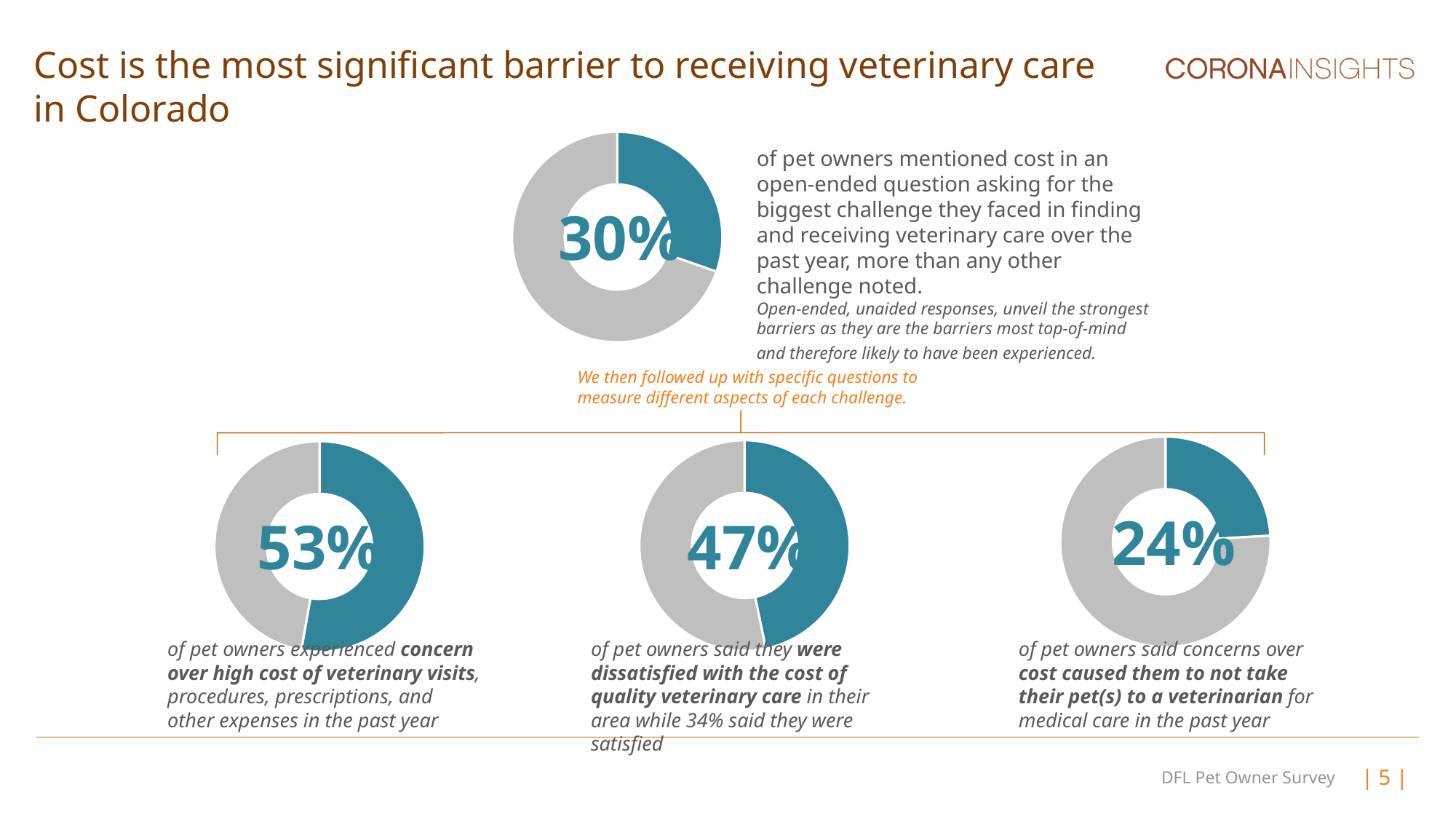
Which of the three bottom donut charts shows the highest percentage? The bottom-left chart (53%) What colour is used for the highlighted slice in each donut chart? Teal Which is larger: the percentage in the bottom-middle donut chart or the percentage in the top donut chart? The bottom-middle chart (47%) What percentage is shown in the bottom-right donut chart? 24% What percentage is shown in the bottom-left donut chart? 53% Which of the three bottom donut charts shows the lowest percentage? The bottom-right chart (24%) What percentage is shown in the bottom-middle donut chart? 47% What kind of chart is used to show the 30% figure at the top of the slide? Donut (pie) chart What is the difference between the percentage in the bottom-left donut chart and the percentage in the bottom-right donut chart? 29 percentage points How many donut charts are on the slide? 4 What percentage is shown in the top donut chart? 30% What share of the bottom-left donut chart is shaded teal? 53%